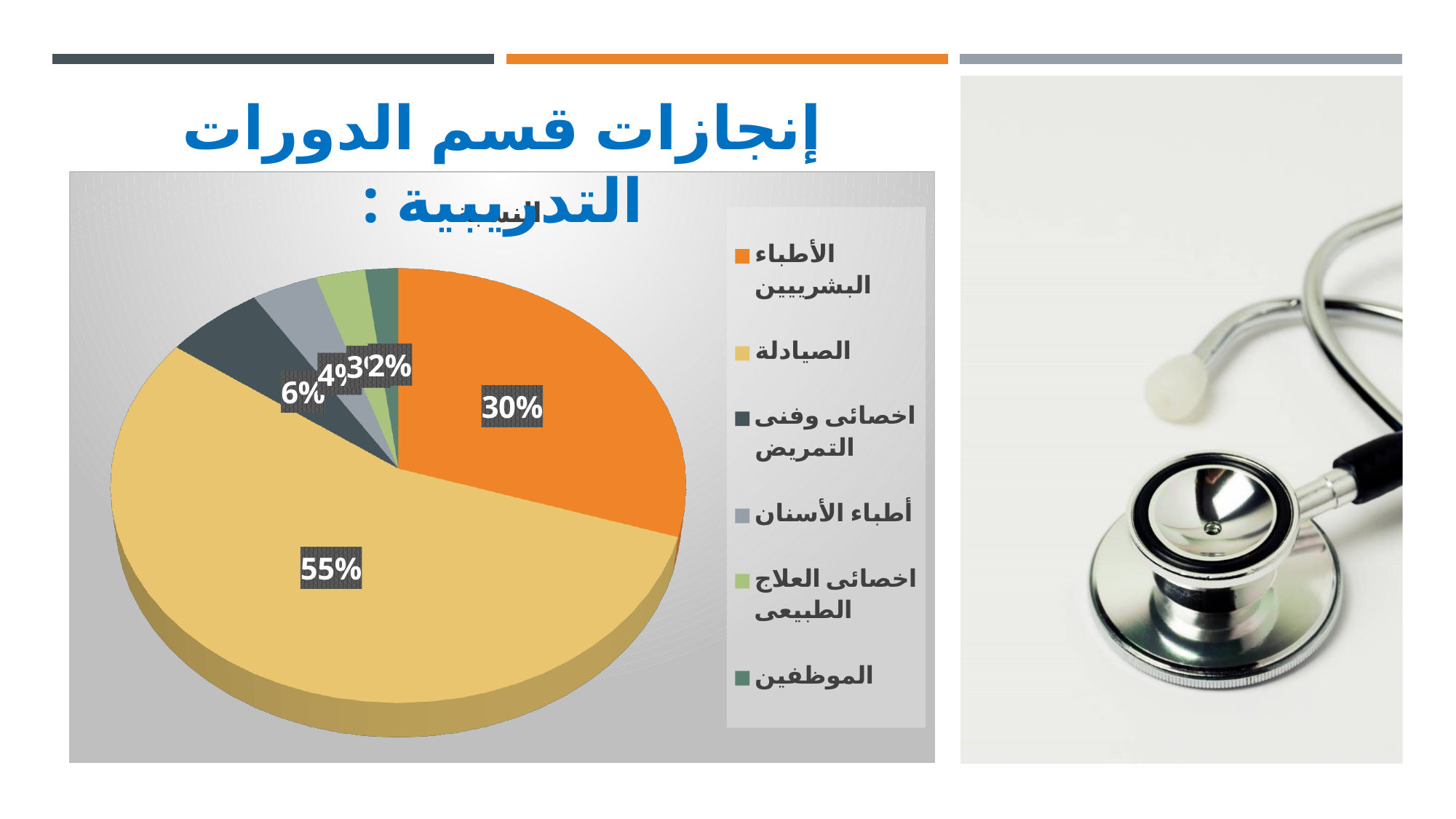
Which category has the largest slice in the pie chart? الصيادلة What is the difference in percentage points between الصيادلة and الأطباء البشريين? 25% What value is shown for اخصائى وفنى التمريض in the pie chart? 6% How many categories does the pie chart legend list? 6 What value is shown for الأطباء البشريين in the pie chart? 30% What is the difference in percentage points between الأطباء البشريين and اخصائى وفنى التمريض? 24% What colour represents الأطباء البشريين in the pie chart? Orange What percentage of the pie chart is the slice for الصيادلة? 55% What type of chart is shown on the slide? Pie chart Which category has the smallest slice in the pie chart? الموظفين Which is larger: the slice for الأطباء البشريين or the slice for اخصائى وفنى التمريض? الأطباء البشريين What value is shown for الموظفين in the pie chart? 2%